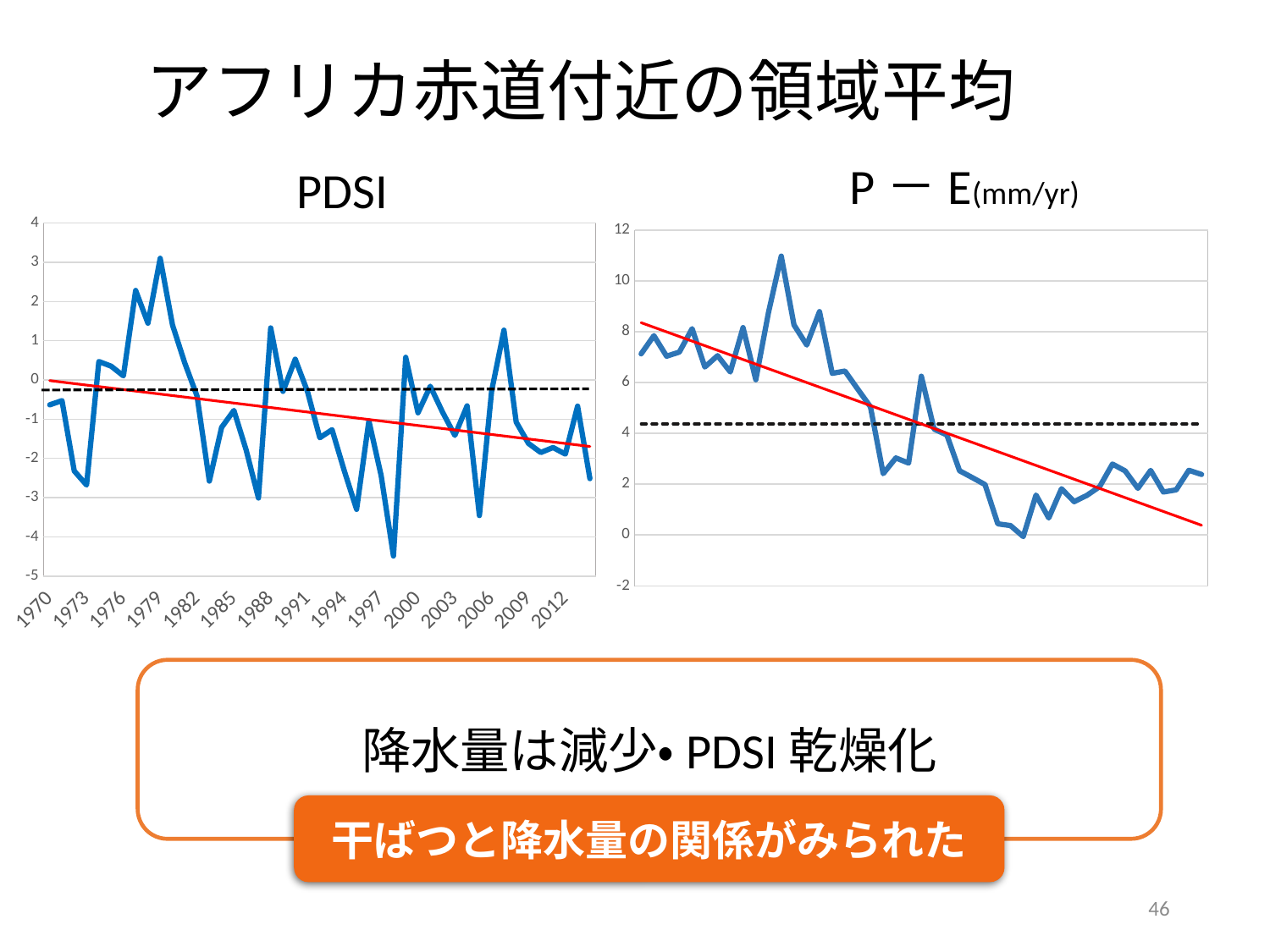
In the PDSI chart, is the highest value of the blue line (around 1979) greater or less than 2? greater What unit is given in the title of the right-hand chart? mm/yr In the P − E chart, is the black dashed horizontal line above or below 4? above What is the maximum value shown on the y axis of the P − E chart? 12 How many year labels are shown on the x axis of the PDSI chart? 15 In the P − E chart, does the red trend line rise or fall from left to right? fall In the P − E chart, is the peak value of the blue line greater or less than 10? greater In the PDSI chart, does the red trend line rise or fall from 1970 to 2012? fall What kind of chart is the P − E chart on the right? line chart What kind of chart is the PDSI chart on the left? line chart